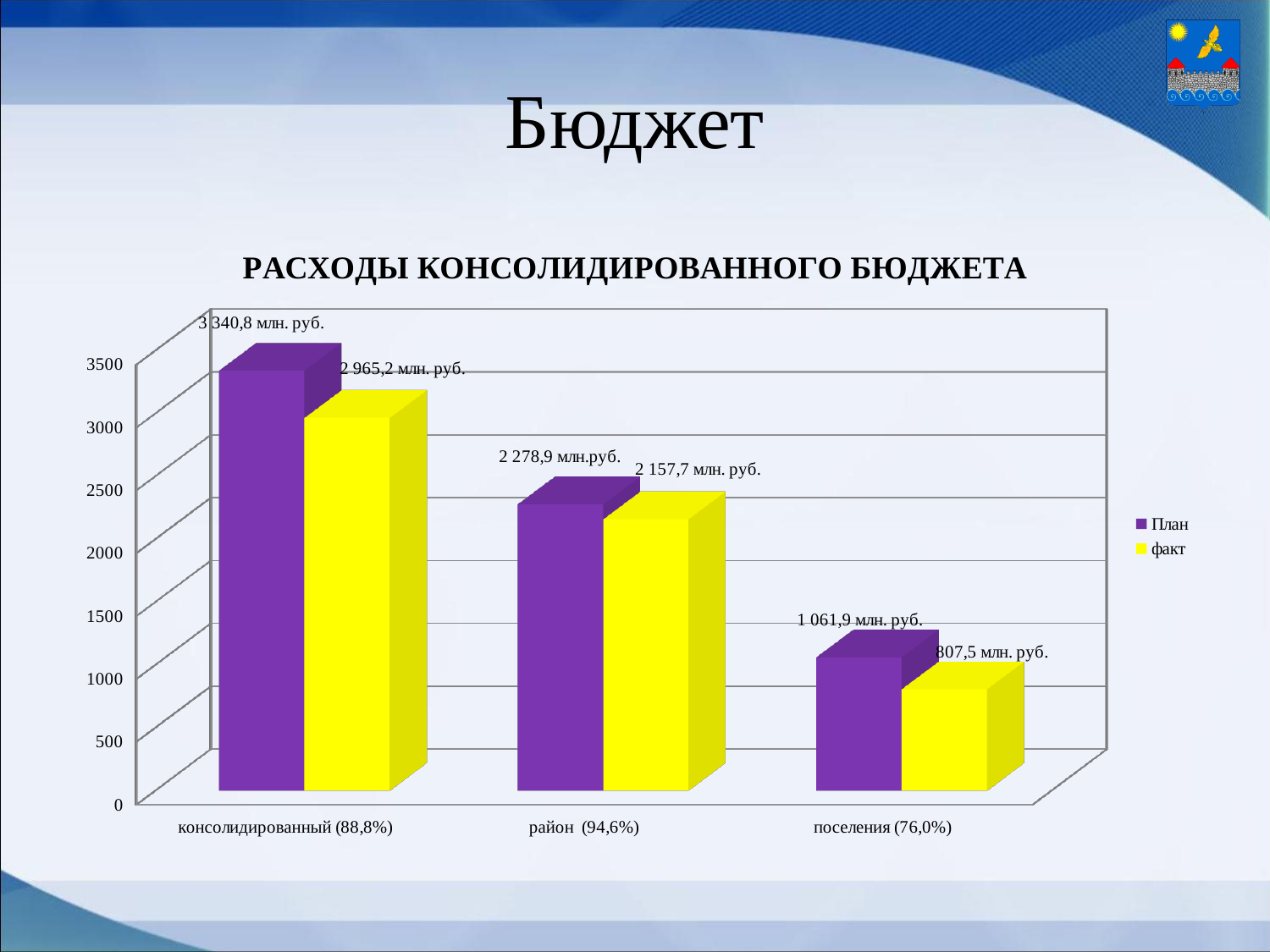
Which category has the lowest факт value? поселения (76,0%) What is the факт value for поселения (76,0%)? 807,5 млн. руб. How many series does the legend list? 2 Is the факт value for район (94,6%) greater or less than 2500? less What is the факт value for консолидированный (88,8%)? 2 965,2 млн. руб. How many categories are shown on the x axis? 3 What is the План value for консолидированный (88,8%)? 3 340,8 млн. руб. What is the difference between План and факт for поселения (76,0%)? 254,4 млн. руб. Which category has the highest План value? консолидированный (88,8%) What is the План value for район (94,6%)? 2 278,9 млн.руб. Which is larger for район (94,6%): План or факт? План What kind of chart is shown on the slide? bar chart